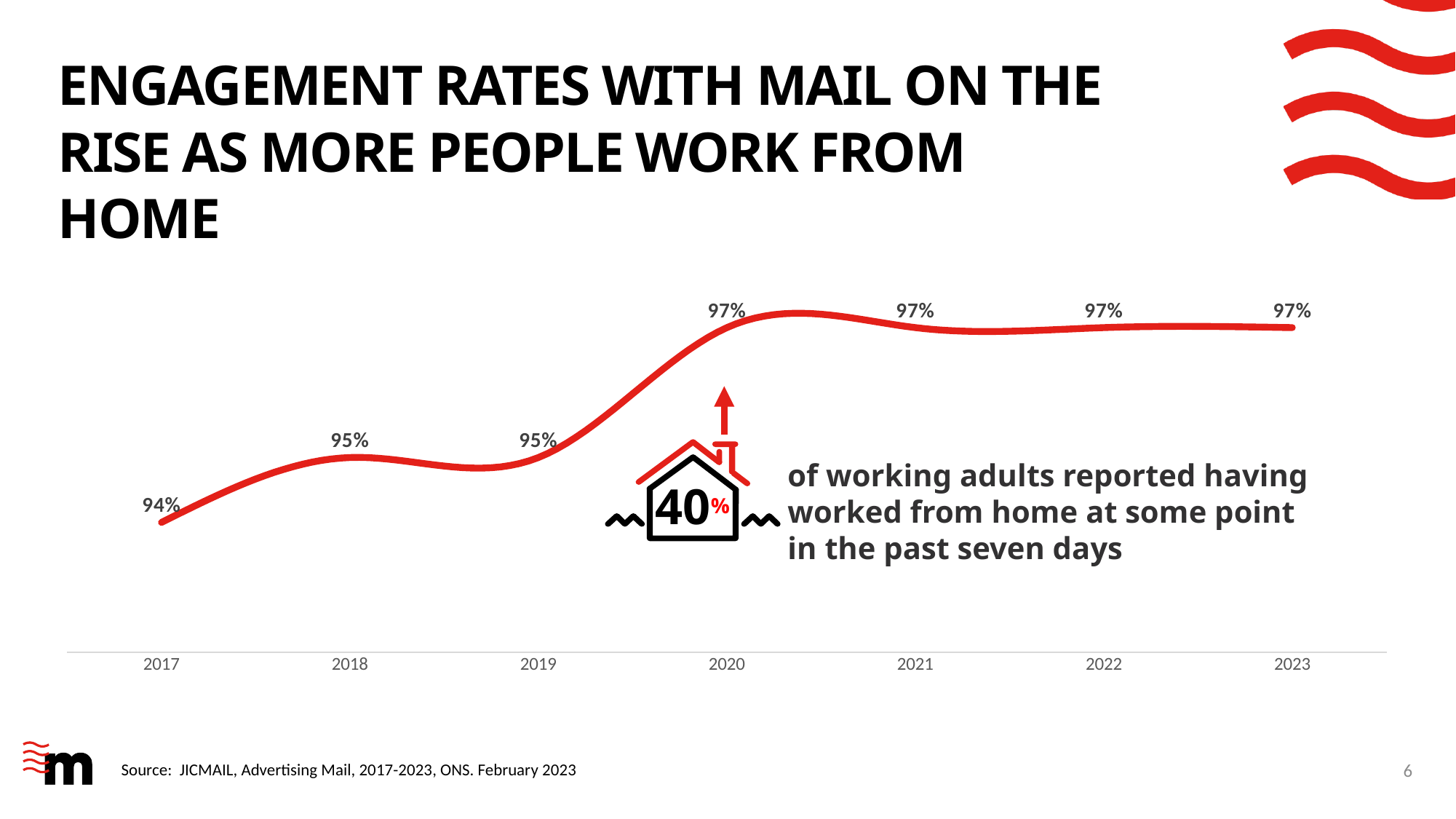
What is the engagement rate with mail in 2017? 94% What is the engagement rate with mail in 2023? 97% What kind of chart is shown on the slide? Line chart What is the difference between the engagement rate in 2020 and in 2017? 3% What is the engagement rate with mail in 2019? 95% What colour is the line on the chart? Red Do the engagement rates generally rise or fall from 2017 to 2023? Rise What is the difference between the engagement rate in 2018 and in 2017? 1% Which is larger, the engagement rate in 2019 or in 2020? 2020 In which year does the engagement rate first reach 97%? 2020 Which year has the lowest engagement rate on the chart? 2017 How many years are plotted on the chart? 7